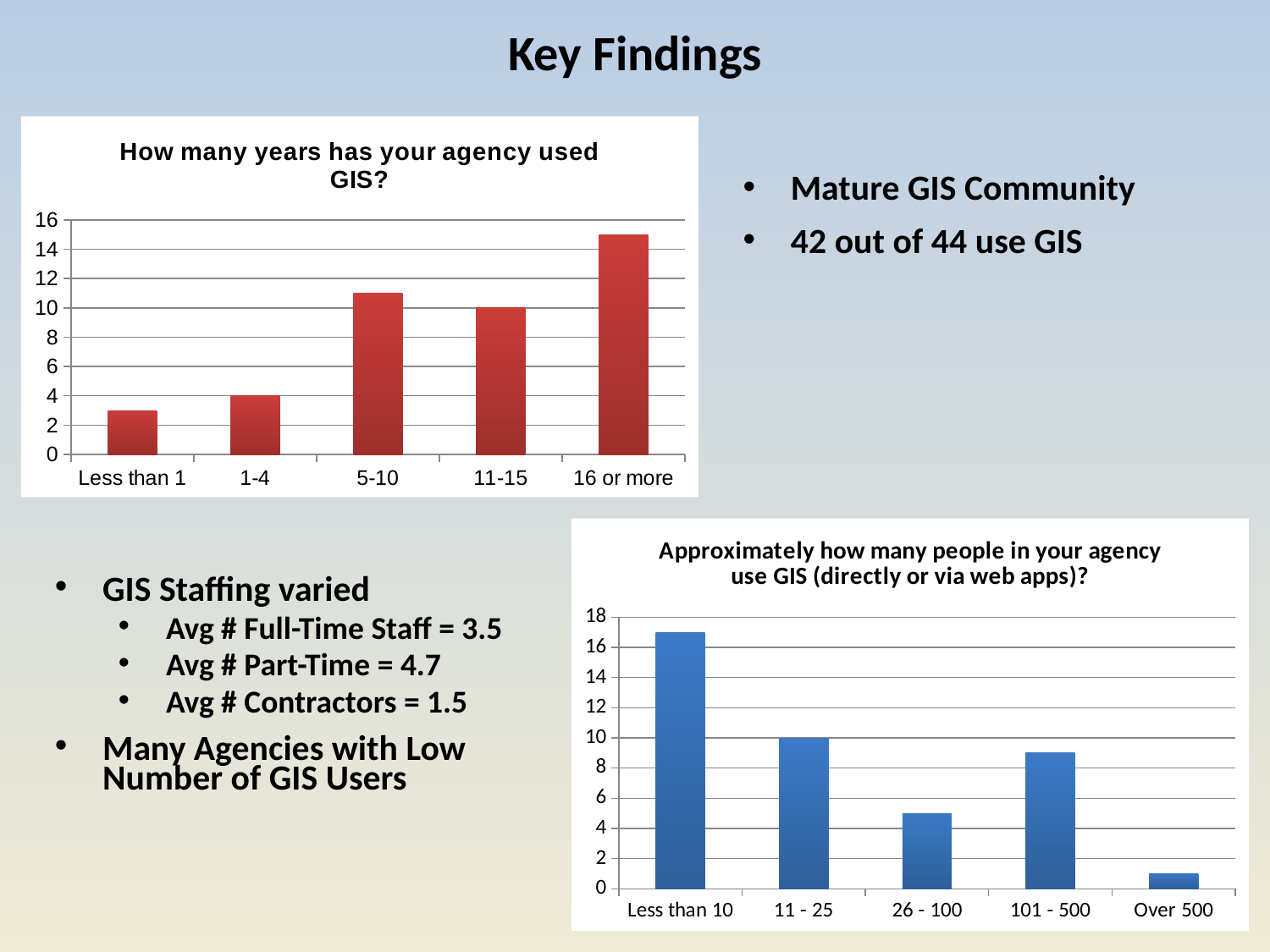
In the chart titled "How many years has your agency used GIS?", what is the value for the 1-4 category? 4 In the chart titled "How many years has your agency used GIS?", what is the value for the 11-15 category? 10 In the chart titled "How many years has your agency used GIS?", which category has the lowest value? Less than 1 In the chart titled "Approximately how many people in your agency use GIS (directly or via web apps)?", is the value for Less than 10 greater or less than 16? greater In the chart titled "How many years has your agency used GIS?", is the value for 16 or more greater or less than 14? greater In the chart titled "How many years has your agency used GIS?", which category has the highest value? 16 or more In the chart titled "Approximately how many people in your agency use GIS (directly or via web apps)?", which category has the highest value? Less than 10 In the chart titled "Approximately how many people in your agency use GIS (directly or via web apps)?", what is the value for the 11 - 25 category? 10 In the chart titled "Approximately how many people in your agency use GIS (directly or via web apps)?", which is larger, the value for 26 - 100 or the value for 101 - 500? 101 - 500 In the chart titled "Approximately how many people in your agency use GIS (directly or via web apps)?", which category has the lowest value? Over 500 In the chart titled "How many years has your agency used GIS?", how many categories are shown on the x axis? 5 What kind of chart is the one titled "Approximately how many people in your agency use GIS (directly or via web apps)?"? bar chart